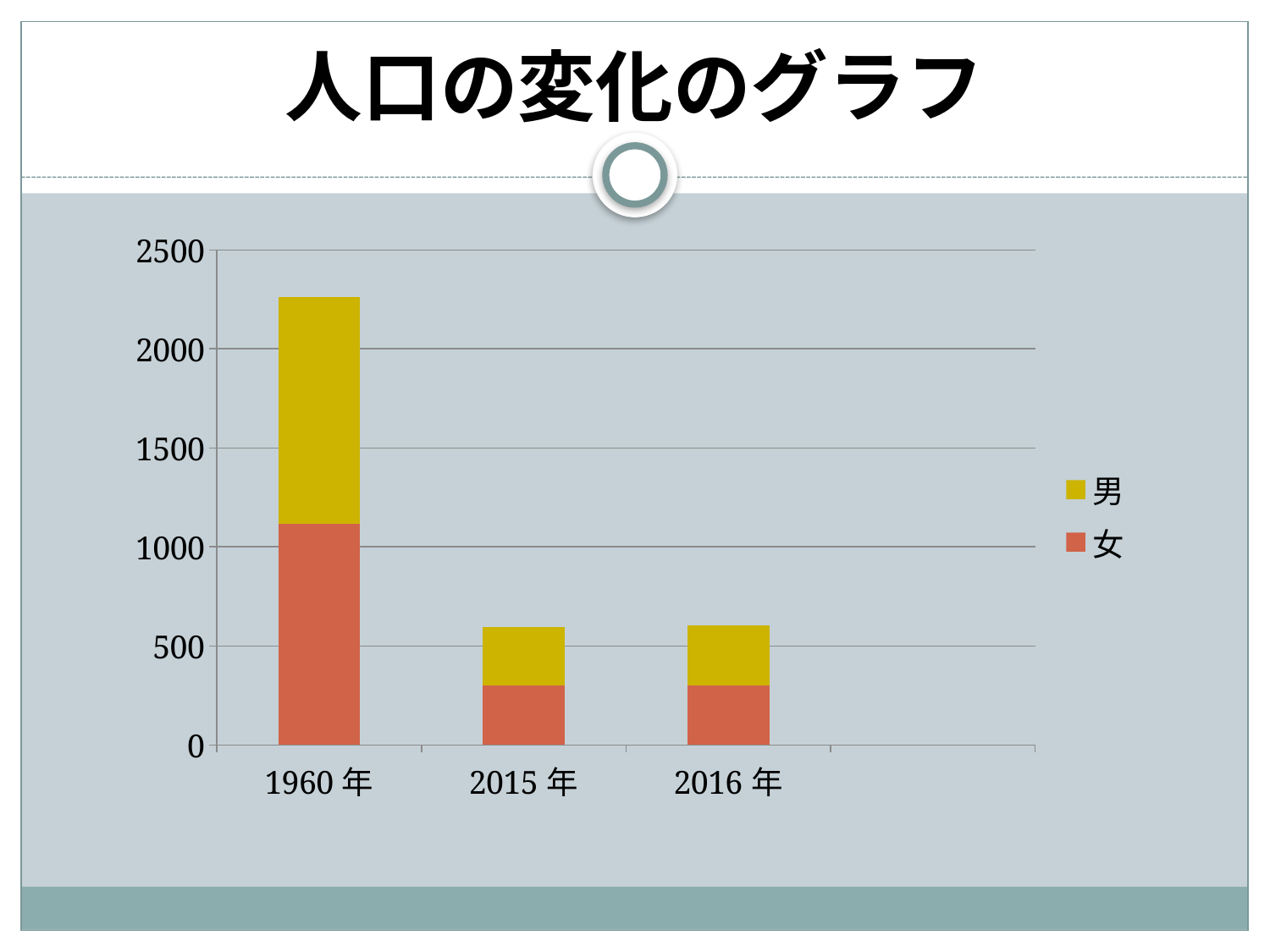
How many series does the legend list? 2 Is the total value for 2015 年 greater or less than 1000? less Which colour represents the 男 series in the legend? Yellow Does the total population rise or fall from 1960 年 to 2015 年? fall What kind of chart is shown on the slide? Stacked bar chart Which category has the highest total bar? 1960 年 Is the 女 value for 2016 年 greater or less than 500? less Which is larger, the total bar for 1960 年 or the total bar for 2015 年? 1960 年 Is the total value for 1960 年 greater or less than 2000? greater How many categories are shown on the x axis? 3 What is the title of the chart on the slide? 人口の変化のグラフ